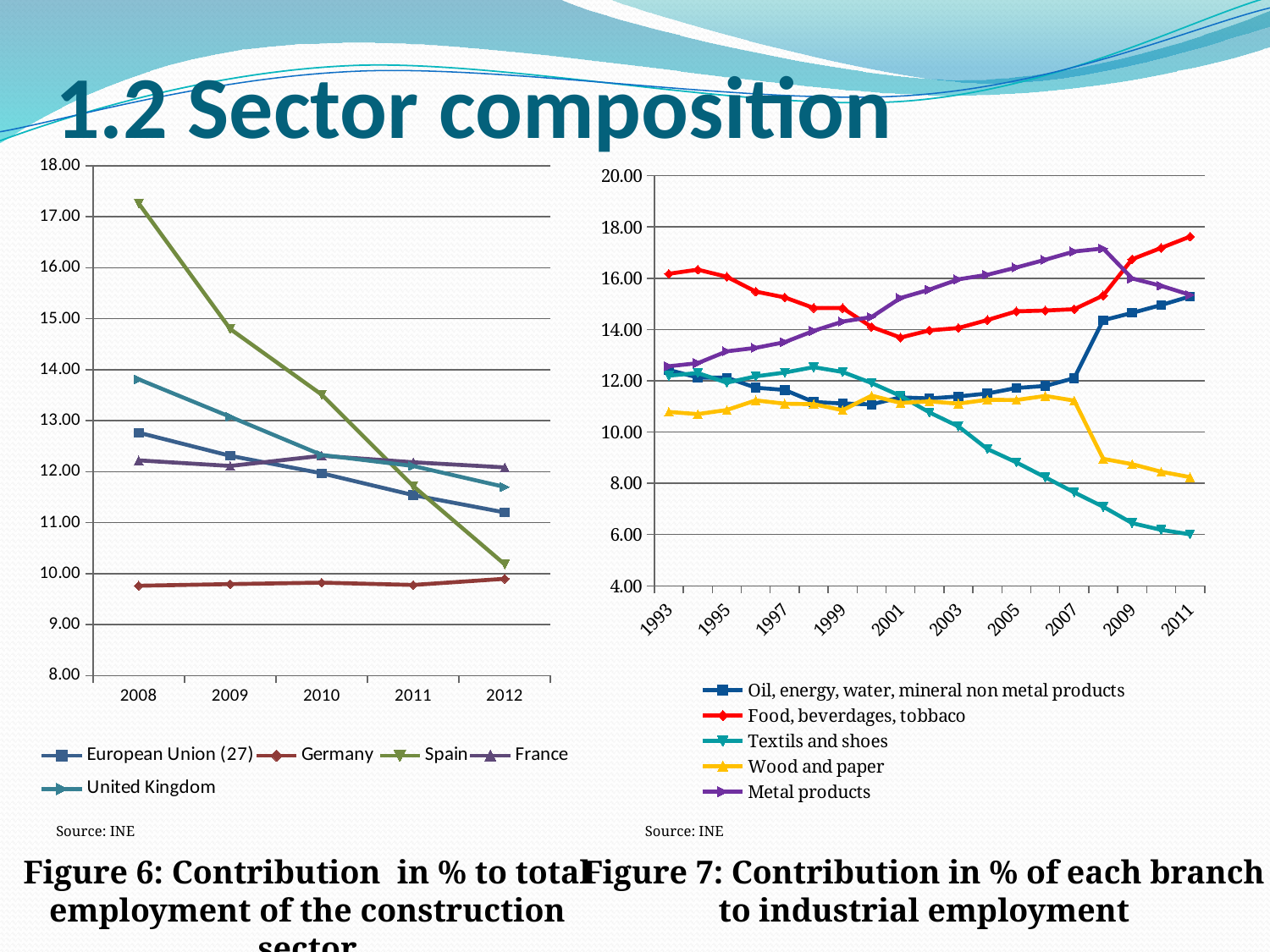
In Figure 6 (the left chart), does the value for Spain rise or fall from 2008 to 2012? Fall What kind of chart is Figure 6 (the left chart)? Line chart What kind of chart is Figure 7 (the right chart)? Line chart How many series does the legend of Figure 6 (the left chart) list? 5 In Figure 7 (the right chart), which branch has the highest value in 2011? Food, beverdages, tobbaco In Figure 7 (the right chart), is the value for Wood and paper in 2011 greater or less than 10.00? less In Figure 6 (the left chart), is the value for Spain in 2008 greater or less than 16.00? greater In Figure 7 (the right chart), does the value for Textils and shoes rise or fall from 1993 to 2011? Fall How many series does the legend of Figure 7 (the right chart) list? 5 In Figure 6 (the left chart), which country has the highest value in 2008? Spain In Figure 7 (the right chart), which branch has the lowest value in 2011? Textils and shoes In Figure 6 (the left chart), which country has the lowest value in 2008? Germany